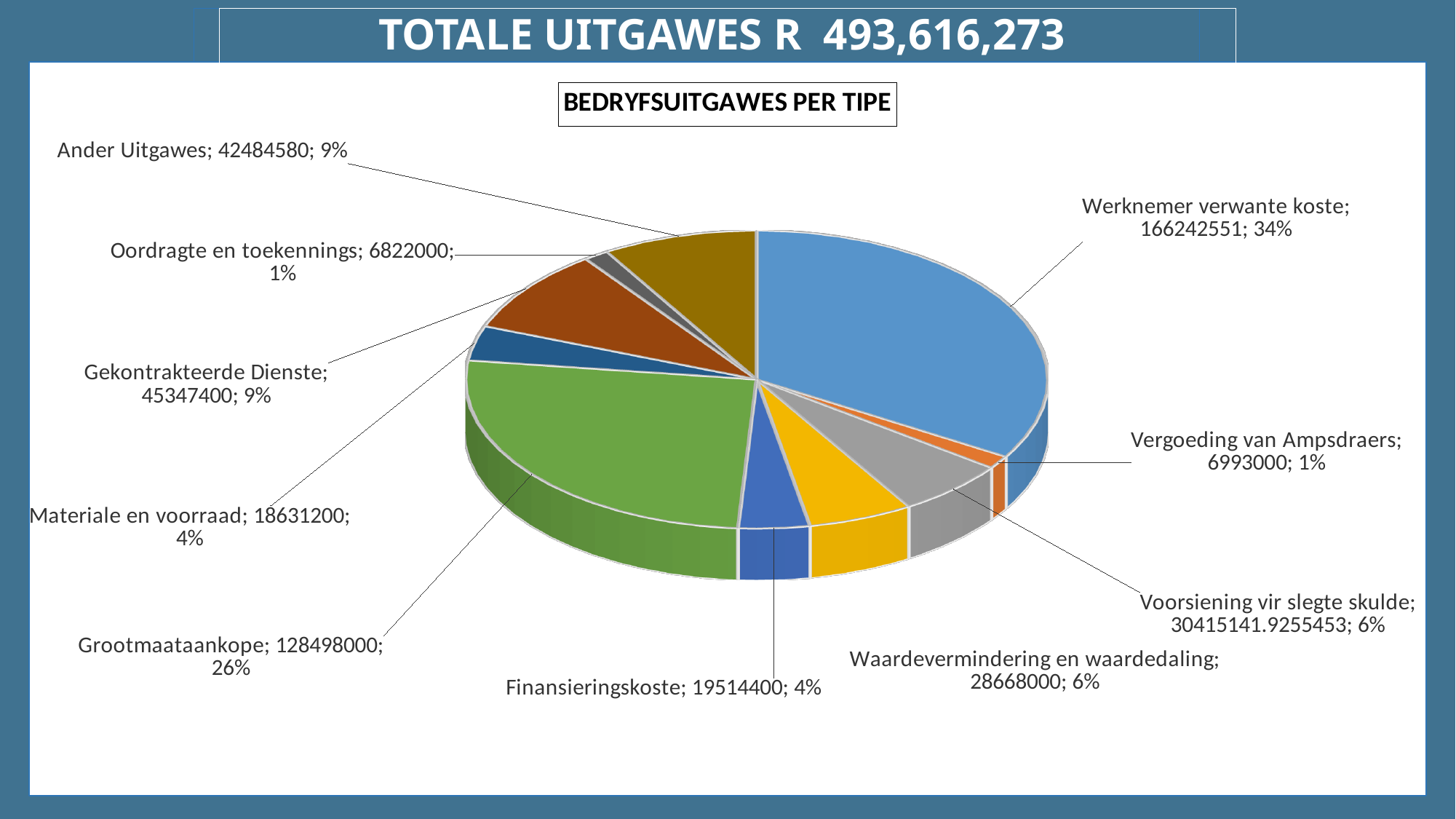
What is the value for Werknemer verwante koste? 166242551 What type of chart is shown on the slide? Pie chart Which category has the smallest value? Oordragte en toekennings What share of the pie does Voorsiening vir slegte skulde represent? 6% Which category has the largest share of the pie? Werknemer verwante koste What share of the pie does Grootmaataankope represent? 26% How many categories (slices) does the pie chart have? 10 What is the value for Gekontrakteerde Dienste? 45347400 What is the value for Finansieringskoste? 19514400 Which is larger, the value for Gekontrakteerde Dienste or the value for Ander Uitgawes? Gekontrakteerde Dienste What is the difference between the values for Werknemer verwante koste and Grootmaataankope? 37744551 What is the title of the chart? BEDRYFSUITGAWES PER TIPE